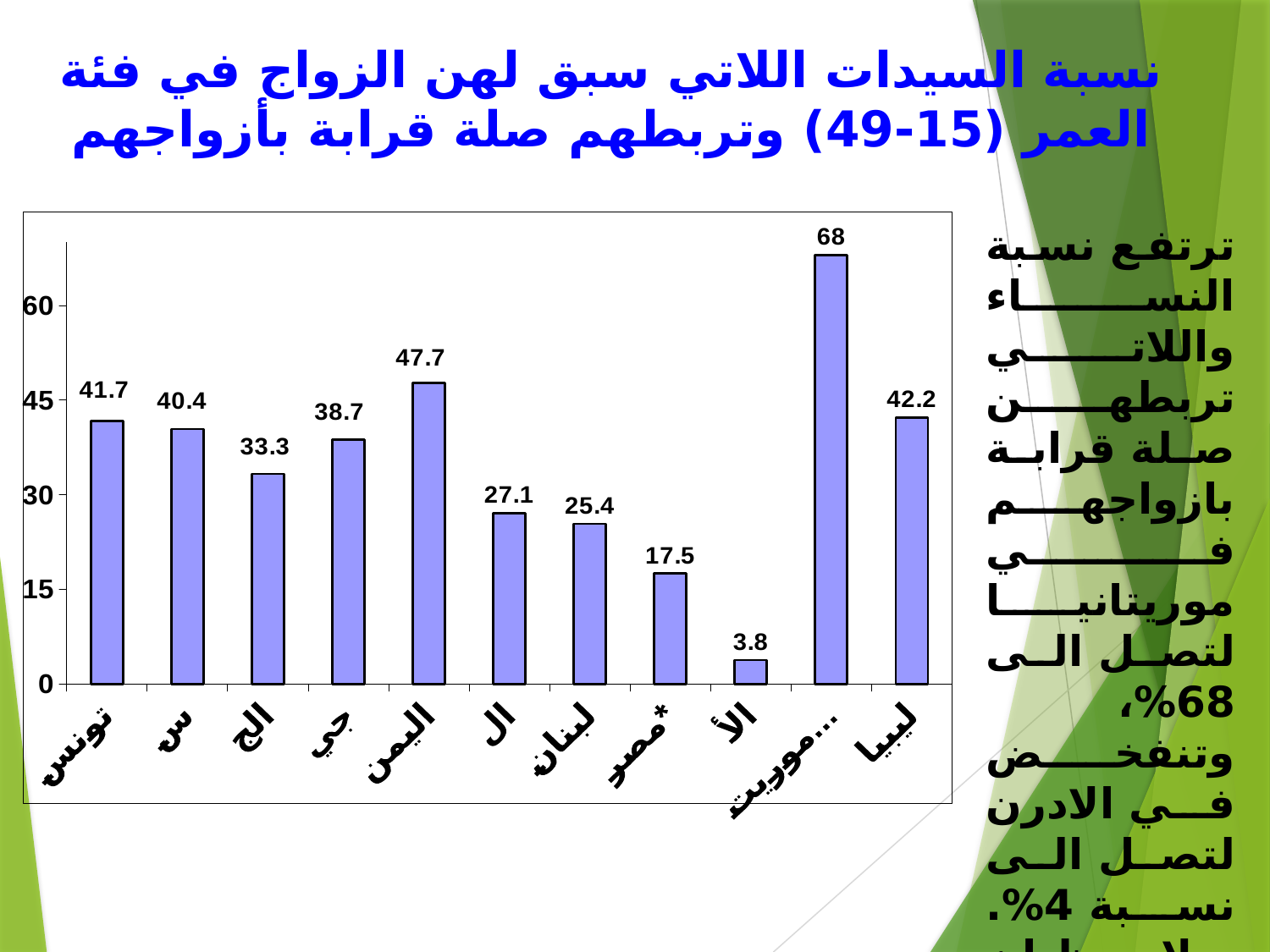
What is the value for تونس? 41.7 What is the lowest value shown on the chart? 3.8 What is the value for ليبيا? 42.2 What is the difference between the values for اليمن and تونس? 6 What is the value for لبنان? 25.4 What is the value for مصر*? 17.5 How many bars are shown on the chart? 11 Is the value for لبنان greater or less than 30? less Which has a larger value, ليبيا or تونس? ليبيا What is the highest value shown on the chart? 68 What is the value for اليمن? 47.7 What kind of chart is shown on the slide? bar chart